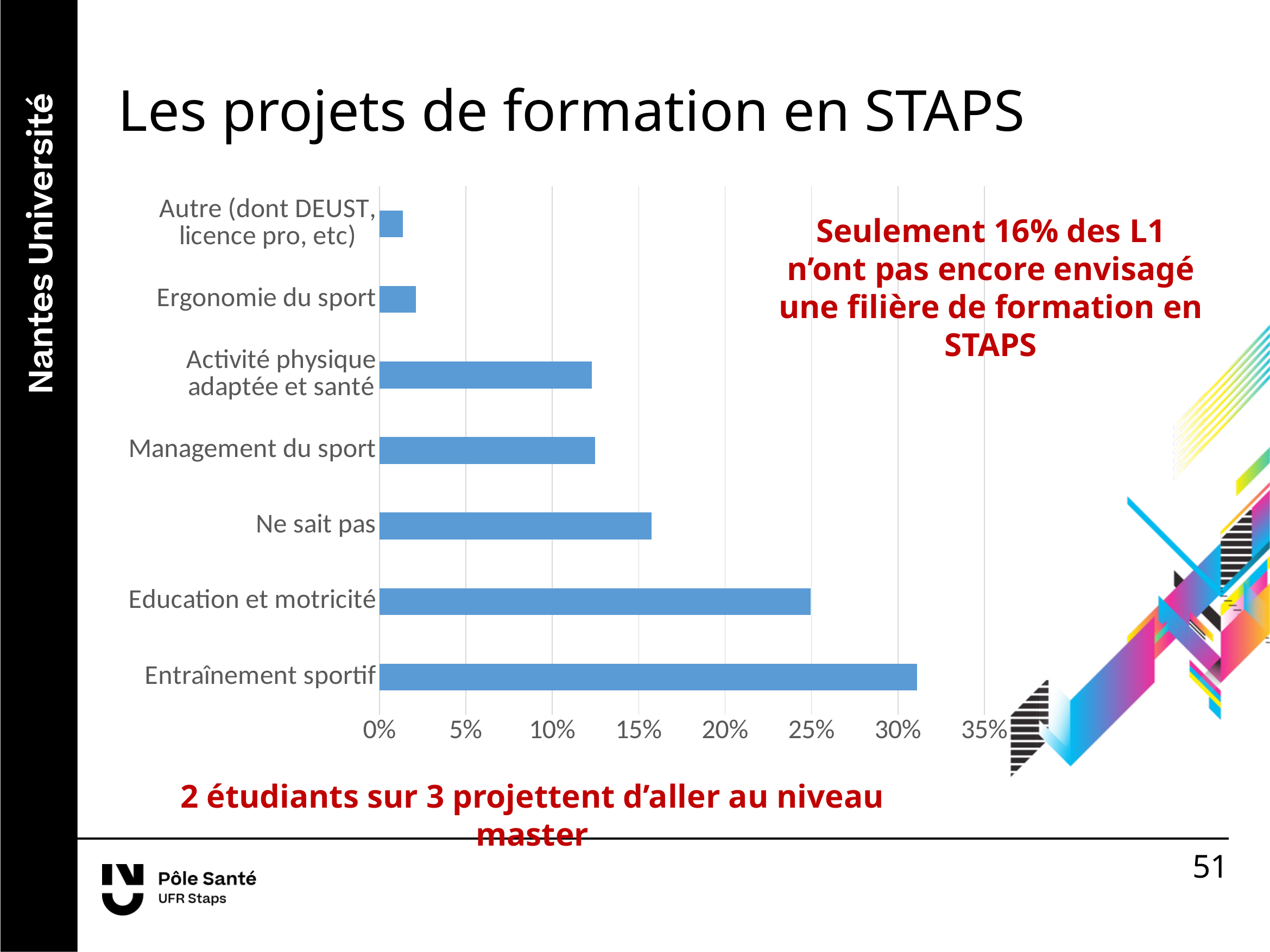
Is the value for Ne sait pas greater or less than 20%? less Which is larger, the value for Activité physique adaptée et santé or the value for Ergonomie du sport? Activité physique adaptée et santé Which category has the highest value in the chart? Entraînement sportif Is the value for Entraînement sportif greater or less than 30%? greater Which is larger, the value for Education et motricité or the value for Ne sait pas? Education et motricité What is the title of the slide containing the chart? Les projets de formation en STAPS Is the value for Education et motricité greater or less than 30%? less What kind of chart is shown on the slide? bar chart How many categories are plotted in the chart? 7 Which category has the lowest value in the chart? Autre (dont DEUST, licence pro, etc)